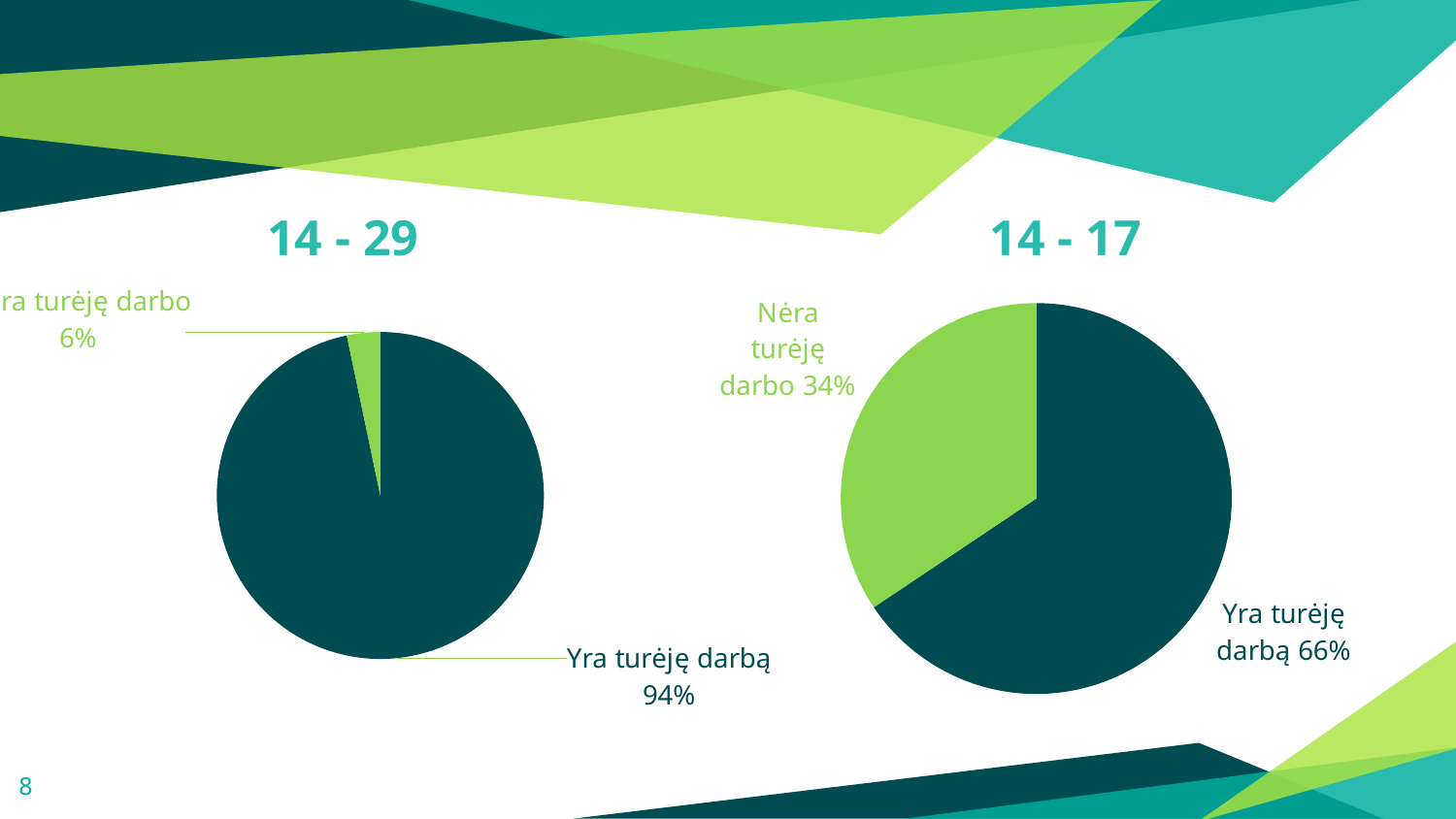
In the "14 - 17" pie chart, what colour is the "Nėra turėję darbo" slice? Green In the "14 - 17" pie chart, what share is labelled "Nėra turėję darbo"? 34% In the "14 - 17" pie chart, which slice is the largest? Yra turėję darbą How many pie charts are shown on the slide? 2 What type of chart is used for the "14 - 17" data? Pie chart Which is larger: the "Yra turėję darbą" share in the "14 - 29" chart or in the "14 - 17" chart? 14 - 29 In the "14 - 29" pie chart, what percentage does the small green slice show? 6% In the "14 - 17" pie chart, what is the difference between the "Yra turėję darbą" and "Nėra turėję darbo" shares? 32% In the "14 - 17" pie chart, what share is labelled "Yra turėję darbą"? 66% How many slices does the "14 - 29" pie chart have? 2 In the "14 - 29" pie chart, what share is labelled "Yra turėję darbą"? 94% In the "14 - 17" pie chart, which slice is the smallest? Nėra turėję darbo